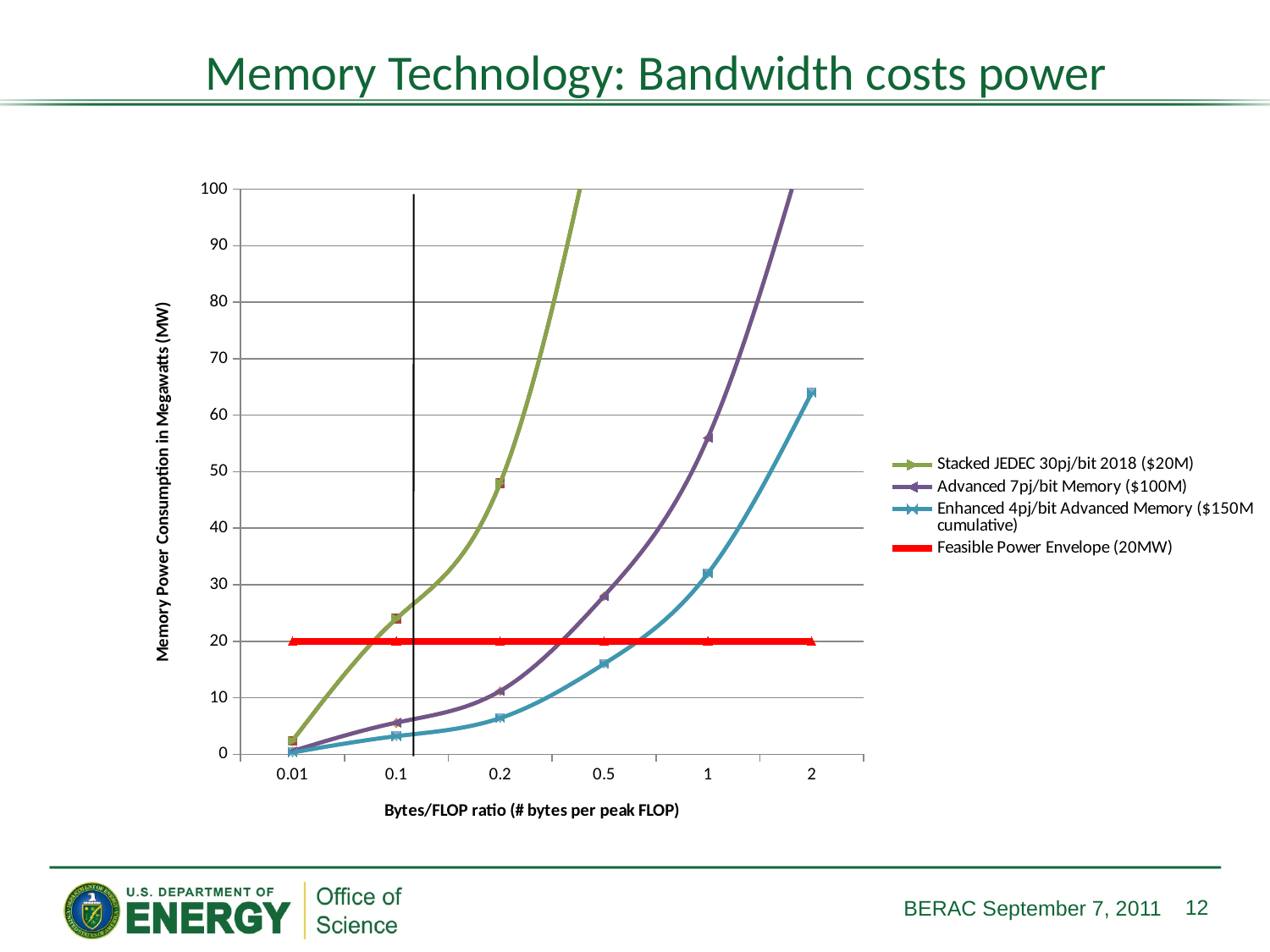
What is the title of the y axis? Memory Power Consumption in Megawatts (MW) What is the value of the Feasible Power Envelope line in megawatts? 20 How many series does the legend list? 4 At a Bytes/FLOP ratio of 0.5, which is larger: Advanced 7pj/bit Memory ($100M) or Enhanced 4pj/bit Advanced Memory ($150M cumulative)? Advanced 7pj/bit Memory ($100M) Which memory technology series has the highest power consumption at a Bytes/FLOP ratio of 0.2? Stacked JEDEC 30pj/bit 2018 ($20M) Is the value for Advanced 7pj/bit Memory ($100M) at a Bytes/FLOP ratio of 1 greater or less than 50? greater Is the value for Enhanced 4pj/bit Advanced Memory ($150M cumulative) at a Bytes/FLOP ratio of 2 greater or less than 60? greater What kind of chart is shown on the slide? line chart Is the value for Enhanced 4pj/bit Advanced Memory ($150M cumulative) at a Bytes/FLOP ratio of 0.5 greater or less than 20? less Does the Enhanced 4pj/bit Advanced Memory ($150M cumulative) series rise or fall as the Bytes/FLOP ratio increases? rise How many Bytes/FLOP ratio values are labelled on the x axis? 6